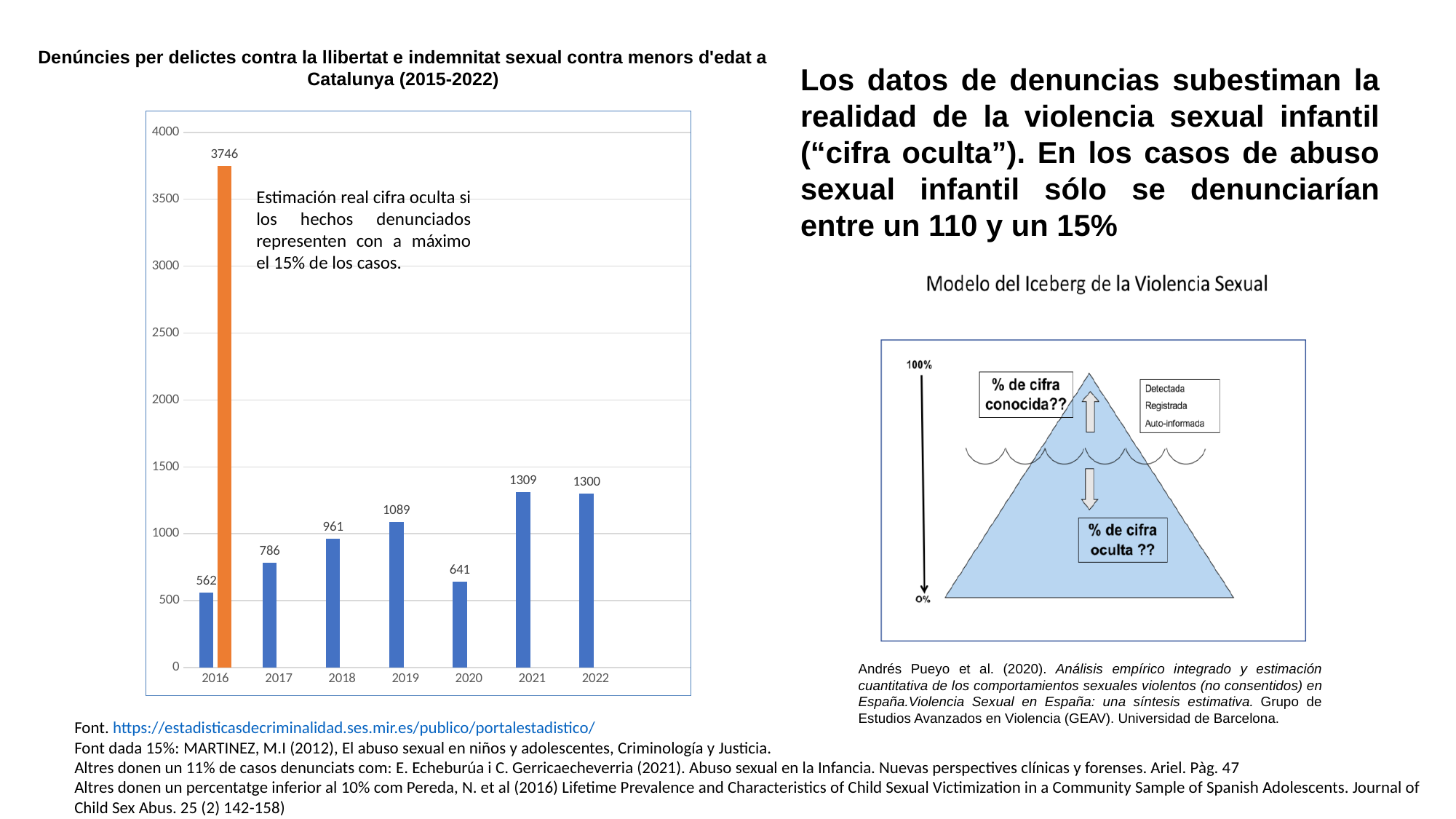
Which year has the highest blue bar? 2021 Do the blue bars rise or fall from 2016 to 2019? Rise What is the value of the orange bar for 2016? 3746 What is the value of the blue bar for 2016? 562 What is the difference between the orange bar (3746) and the blue bar (562) for 2016? 3184 What type of chart is shown on the left of the slide? Bar chart Which is larger, the value for 2019 or the value for 2020? 2019 How many years are shown on the x axis of the chart? 7 What is the value of the blue bar for 2020? 641 Which year has the lowest blue bar? 2016 What is the difference between the 2021 value (1309) and the 2022 value (1300)? 9 What is the number of reports (blue bar) for 2017? 786